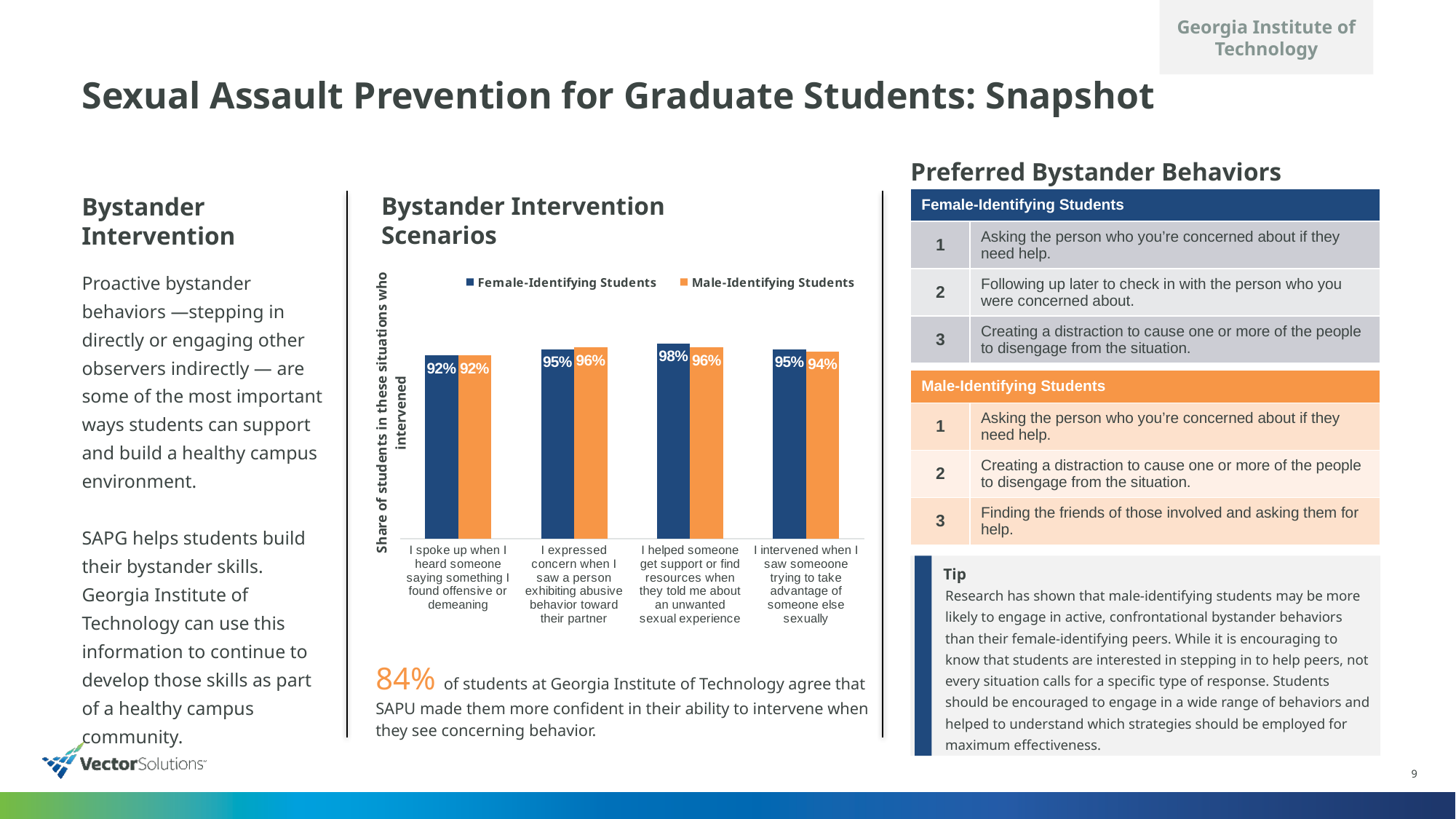
What is the value for Female-Identifying Students in the scenario 'I helped someone get support or find resources when they told me about an unwanted sexual experience'? 98% What is the difference between Female-Identifying and Male-Identifying Students in the scenario 'I helped someone get support or find resources when they told me about an unwanted sexual experience'? 2% How many series does the chart legend list? 2 Which scenario has the highest value for Female-Identifying Students? I helped someone get support or find resources when they told me about an unwanted sexual experience What colour represents Male-Identifying Students in the chart? Orange What is the value for Male-Identifying Students in the scenario 'I intervened when I saw someoone trying to take advantage of someone else sexually'? 94% What is the value for Male-Identifying Students in the scenario 'I spoke up when I heard someone saying something I found offensive or demeaning'? 92% What is the title of the chart? Bystander Intervention Scenarios Which scenario has the lowest value for Male-Identifying Students? I spoke up when I heard someone saying something I found offensive or demeaning In the scenario 'I expressed concern when I saw a person exhibiting abusive behavior toward their partner', which series has the larger value? Male-Identifying Students How many scenarios (categories) are shown on the x axis of the chart? 4 What kind of chart is used for Bystander Intervention Scenarios? Bar chart